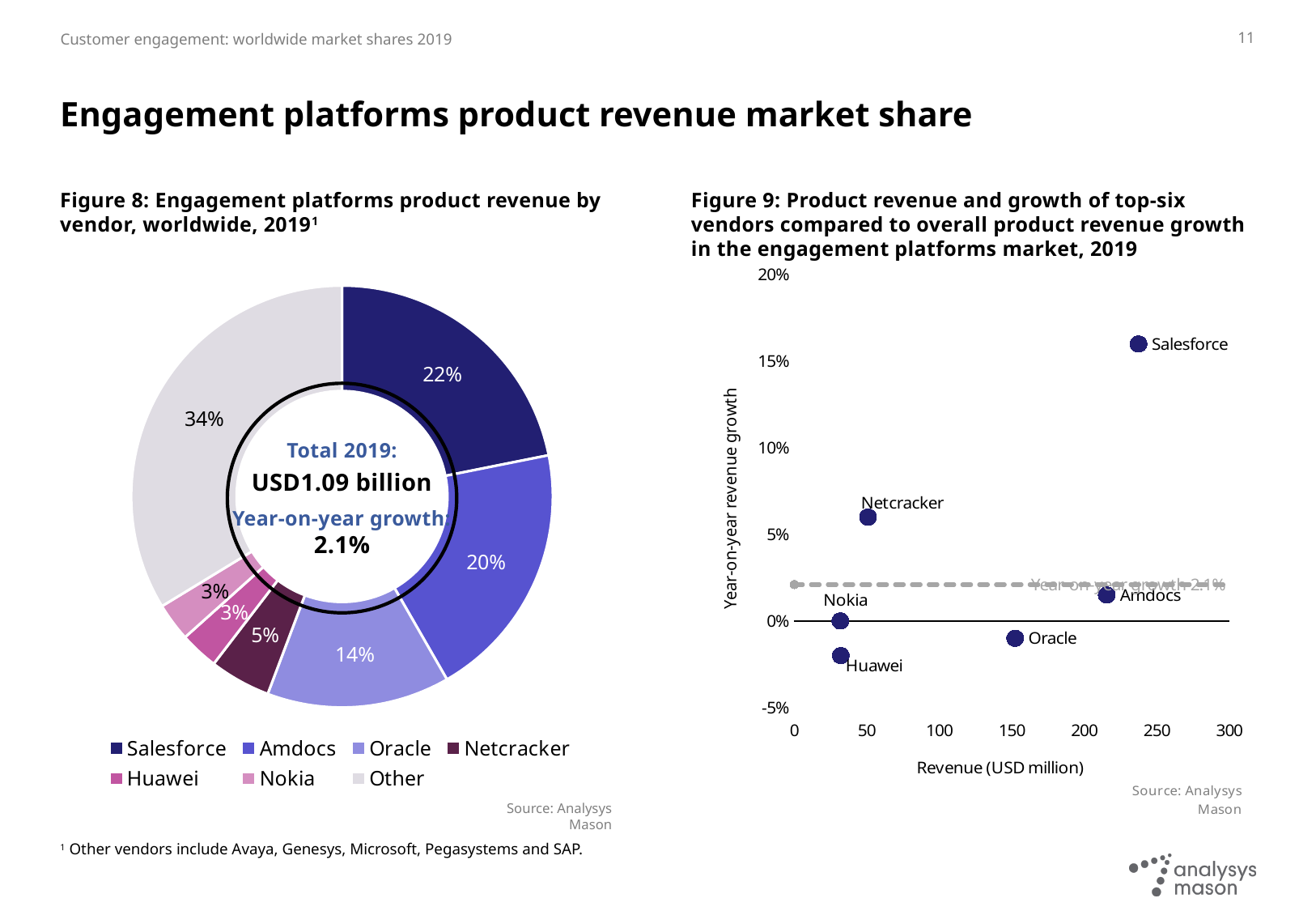
In Figure 9, is Salesforce's year-on-year revenue growth greater or less than 10%? greater In Figure 9, which vendor has the highest year-on-year revenue growth? Salesforce In Figure 8, what is the total 2019 revenue shown in the centre of the chart? USD1.09 billion What kind of chart is Figure 8? Pie (donut) chart In Figure 8, which segment is the largest? Other In Figure 9, which vendor has the lowest year-on-year revenue growth? Huawei In Figure 8, what share does Oracle hold? 14% In Figure 8, what share does Netcracker hold? 5% In Figure 8, how many segments does the legend list? 7 In Figure 8, how many percentage points larger is Salesforce's share than Amdocs's share? 2 percentage points In Figure 8, what share of engagement platforms product revenue does Salesforce hold? 22% In Figure 9, is Oracle's revenue greater or less than 100 USD million? greater